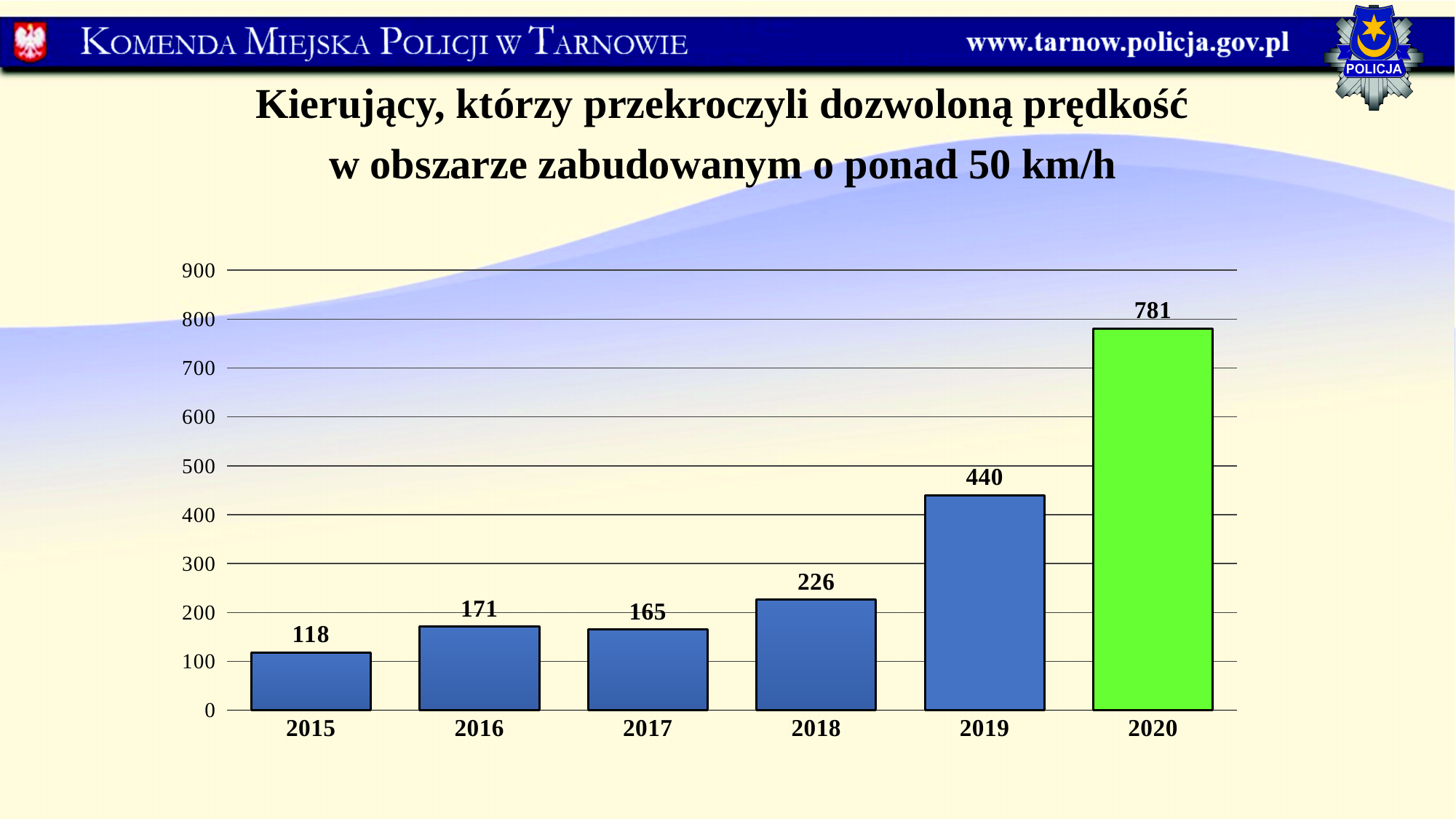
Which year has the highest value? 2020 What is the value for 2020? 781 What is the difference between the values for 2016 and 2017? 6 Which is larger, the value for 2018 or the value for 2019? 2019 How many years are shown on the x axis? 6 What is the value for 2018? 226 Which bar is coloured green rather than blue? 2020 Is the value for 2019 greater or less than 400? greater What is the value for 2015? 118 Which year has the lowest value? 2015 What kind of chart is shown on the slide? bar chart What is the difference between the values for 2020 and 2019? 341